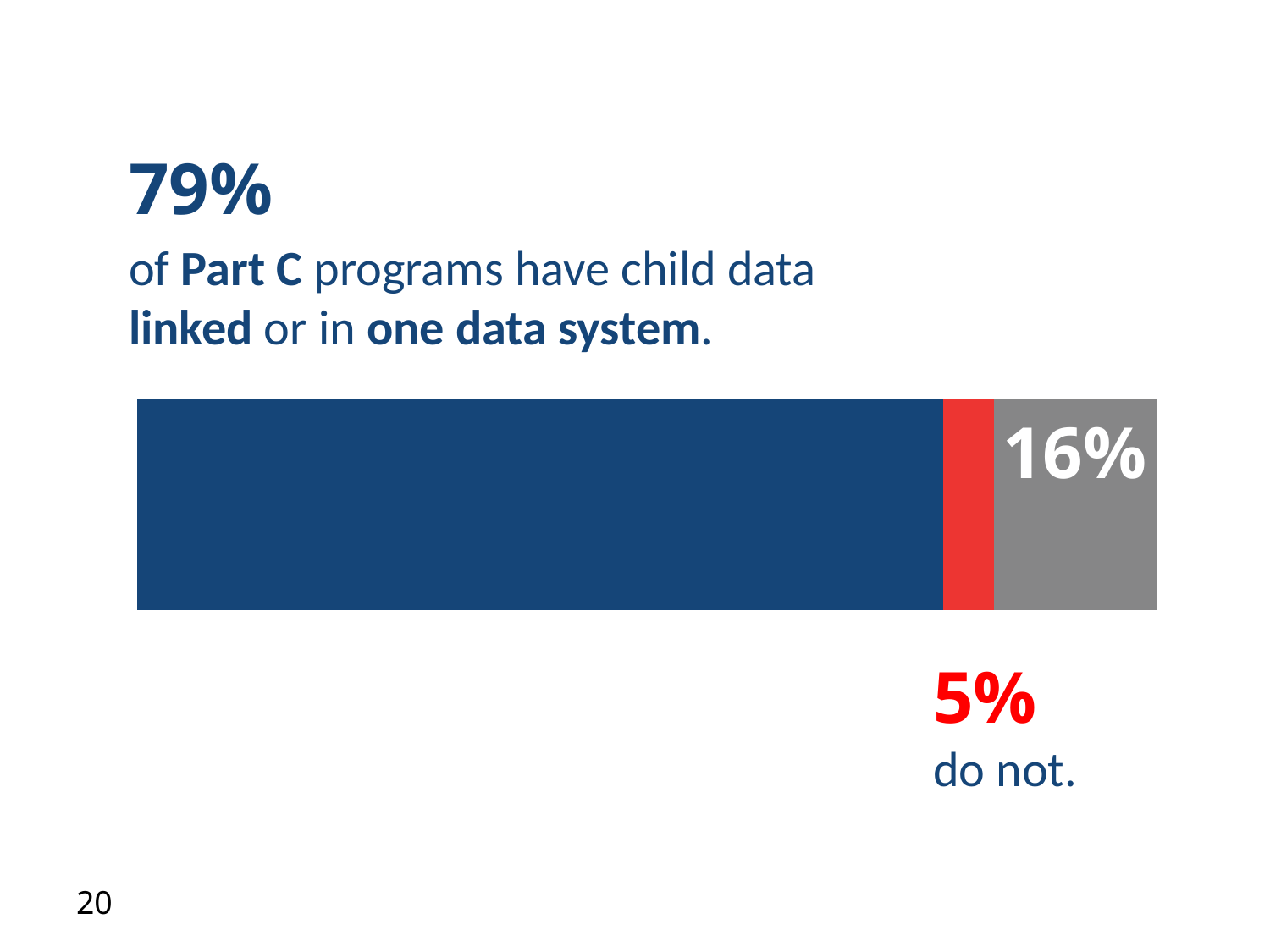
Which is larger, the gray segment or the red segment? The gray segment (16%) What value is printed on the gray segment of the bar? 16% What is the difference between the gray segment (16%) and the red segment (5%)? 11% What colour is the segment representing the 5% of programs that do not have linked data? Red How many segments does the stacked bar contain? 3 What percentage of Part C programs have child data linked or in one data system? 79% What is the difference between the share of programs with linked data (79%) and the share that do not (5%)? 74% Which segment of the bar has the smallest value? 5% (red, do not) What kind of chart is shown on the slide? A stacked horizontal bar chart Which segment of the bar has the largest value? 79% (blue, linked or in one data system) What is the total of all three segments of the stacked bar? 100% What percentage of Part C programs do not have child data linked or in one data system? 5%